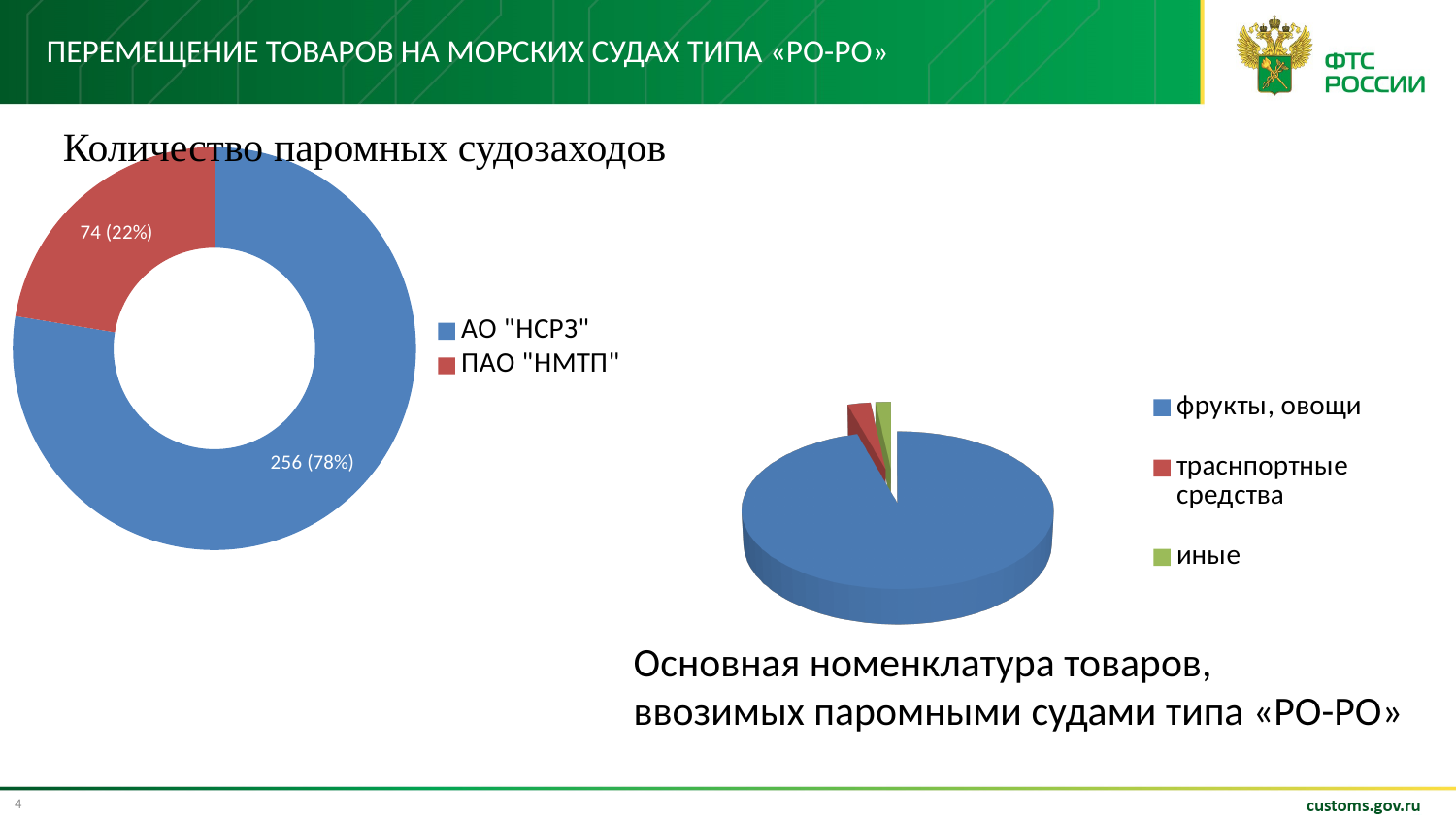
In the chart "Количество паромных судозаходов", what is the total number of ferry port calls across both categories? 330 What kind of chart is the chart "Количество паромных судозаходов"? Doughnut chart In the chart "Основная номенклатура товаров, ввозимых паромными судами типа «РО-РО»", which category has the largest slice? фрукты, овощи How many categories does the legend of the chart "Количество паромных судозаходов" list? 2 How many categories does the legend of the chart "Основная номенклатура товаров, ввозимых паромными судами типа «РО-РО»" list? 3 In the chart "Количество паромных судозаходов", what is the difference between the counts for АО "НСРЗ" and ПАО "НМТП"? 182 In the chart "Количество паромных судозаходов", which category has the smallest share? ПАО "НМТП" In the chart "Количество паромных судозаходов", which category has the largest share? АО "НСРЗ" In the chart "Основная номенклатура товаров, ввозимых паромными судами типа «РО-РО»", what colour is the slice for "иные"? Green In the chart "Количество паромных судозаходов", what is the value shown for АО "НСРЗ"? 256 (78%) In the chart "Количество паромных судозаходов", what is the value shown for ПАО "НМТП"? 74 (22%) In the chart "Количество паромных судозаходов", what share of the total does ПАО "НМТП" account for? 22%